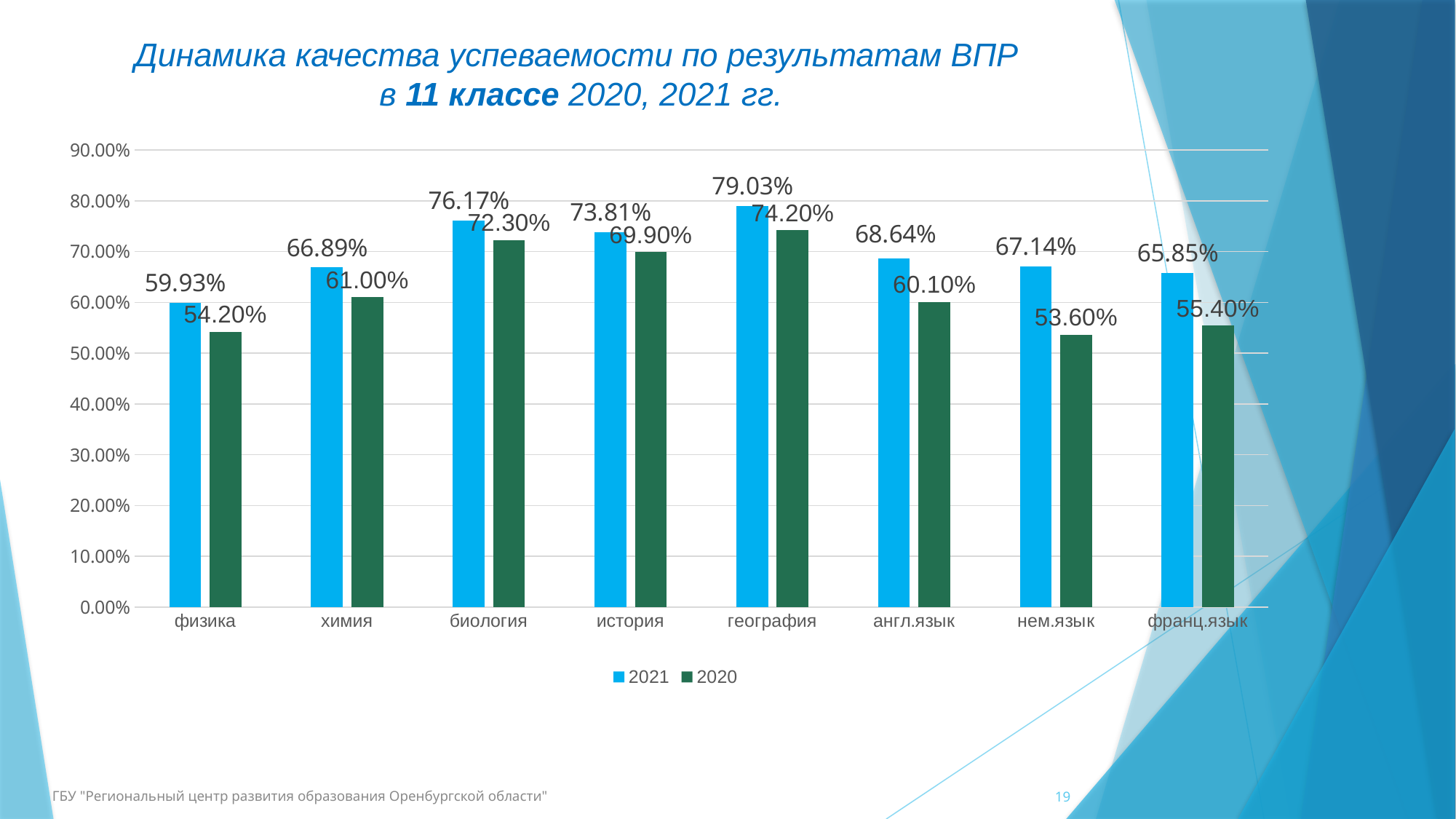
What is the 2020 value for нем.язык? 53.60% What is the 2021 value for англ.язык? 68.64% Which is larger for химия: the 2021 value or the 2020 value? 2021 How many subjects are shown on the x axis? 8 Which subject has the lowest 2021 value? физика What is the difference between the 2021 and 2020 values for нем.язык? 13.54 percentage points What kind of chart is shown on the slide? Bar chart What is the difference between the 2021 and 2020 values for география? 4.83 percentage points What is the 2021 value for физика? 59.93% How many series does the legend list? 2 Which subject has the lowest 2020 value? нем.язык Which subject has the highest 2021 value? география